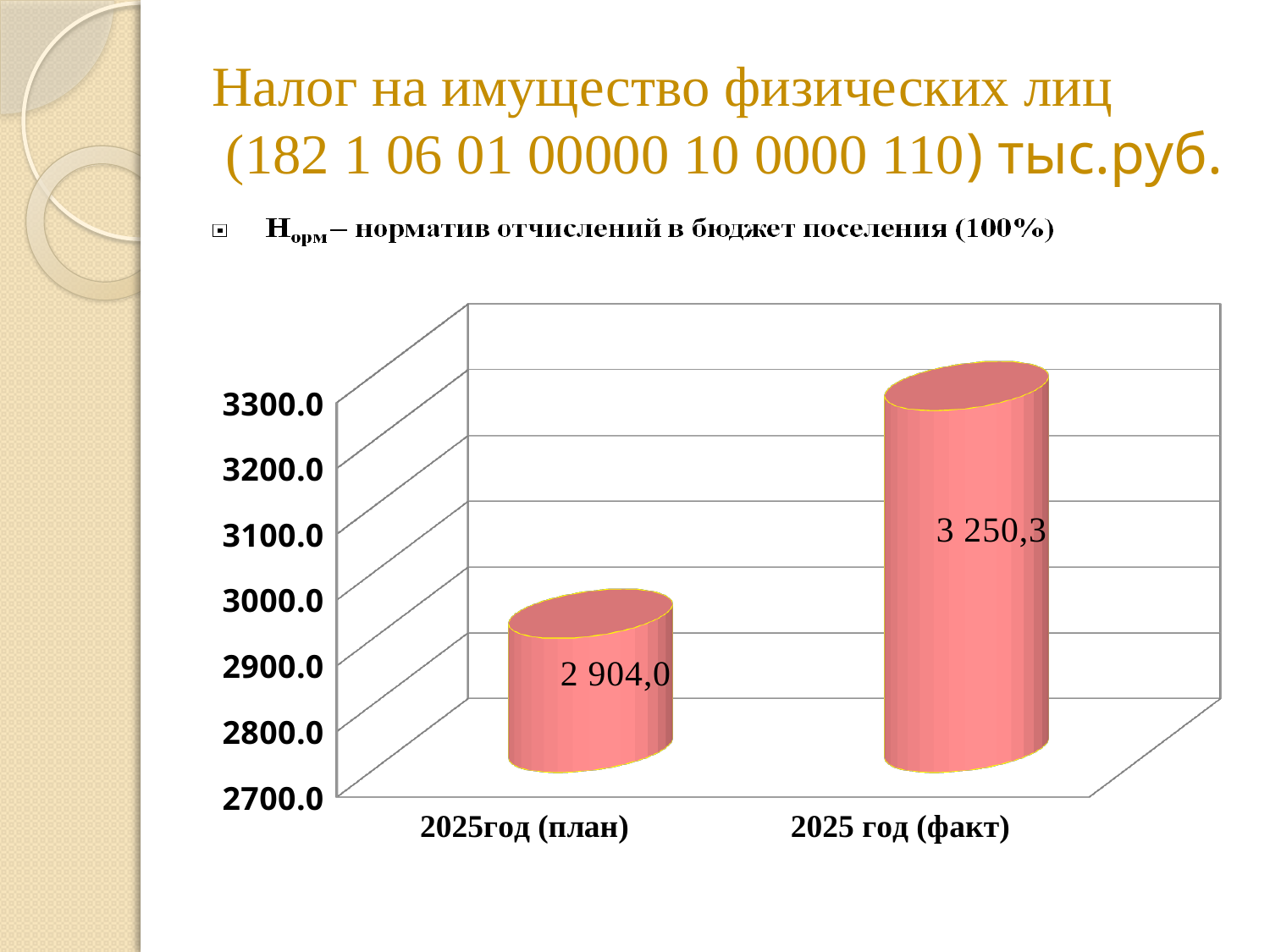
Is the value for 2025 год (факт) greater or less than 3200.0? greater What is the value for 2025год (план)? 2 904,0 Which category has the lowest value? 2025год (план) Which category has the highest value? 2025 год (факт) What kind of chart is shown on the slide? bar chart Is the value for 2025год (план) greater or less than 3000.0? less What is the lowest value shown on the y axis of the chart? 2700.0 Do the values rise or fall from 2025год (план) to 2025 год (факт)? rise How many categories are shown on the x axis of the chart? 2 What is the value for 2025 год (факт)? 3 250,3 Which is larger, the value for 2025год (план) or the value for 2025 год (факт)? 2025 год (факт) What is the difference between the value for 2025 год (факт) and the value for 2025год (план)? 346,3